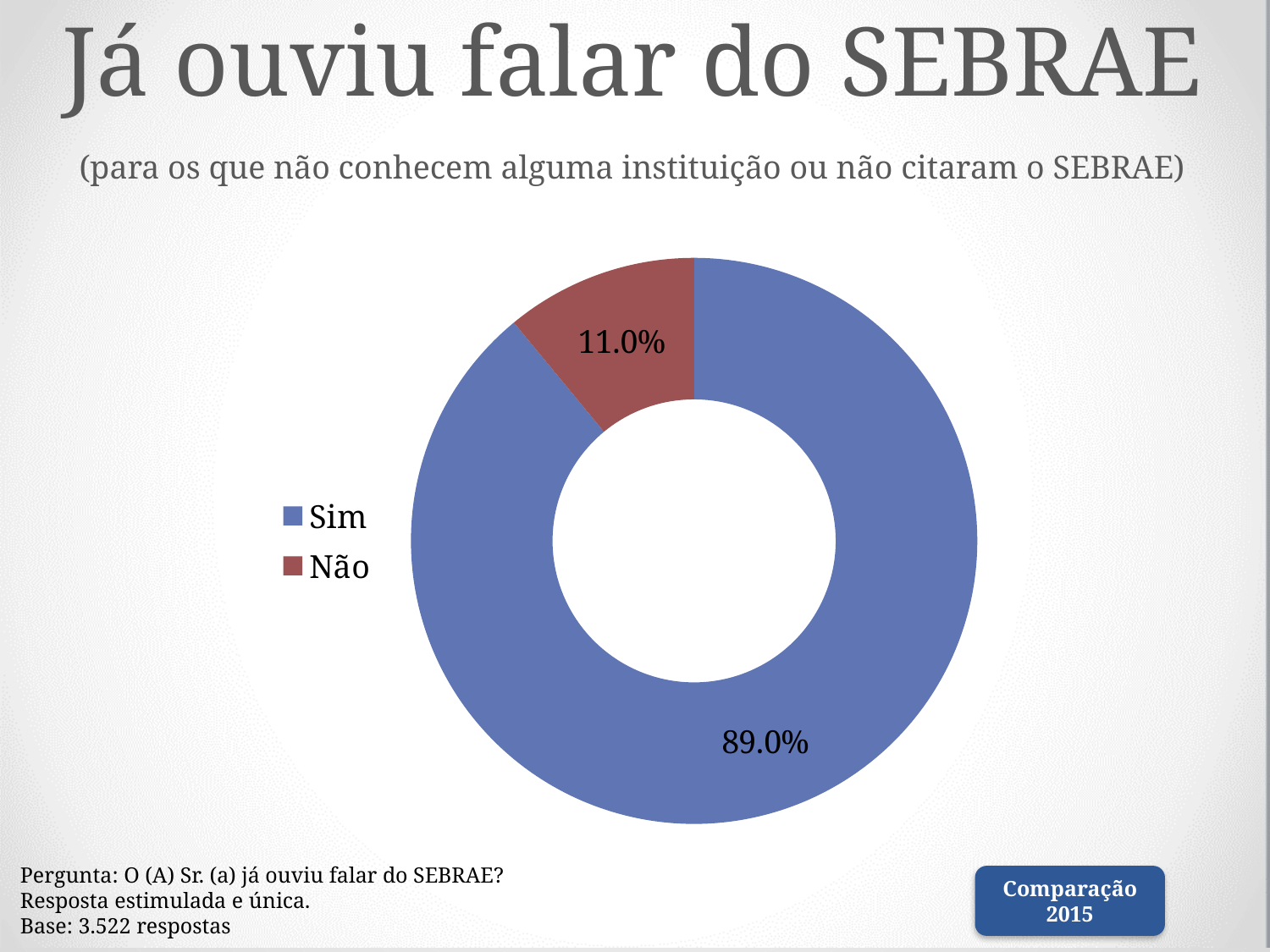
What kind of chart is shown on the slide? Doughnut (pie) chart Which is larger, the share for "Sim" or the share for "Não"? Sim What percentage of respondents answered "Não"? 11.0% What colour is the "Sim" slice? Blue What is the difference in percentage points between "Sim" and "Não"? 78.0 percentage points What percentage of respondents answered "Sim"? 89.0% Which category has the largest share of the chart? Sim What is the base (number of responses) stated on the slide? 3.522 respostas Which category has the smallest share of the chart? Não How many categories are shown in the chart? 2 What share of the chart does the "Não" slice represent? 11.0%